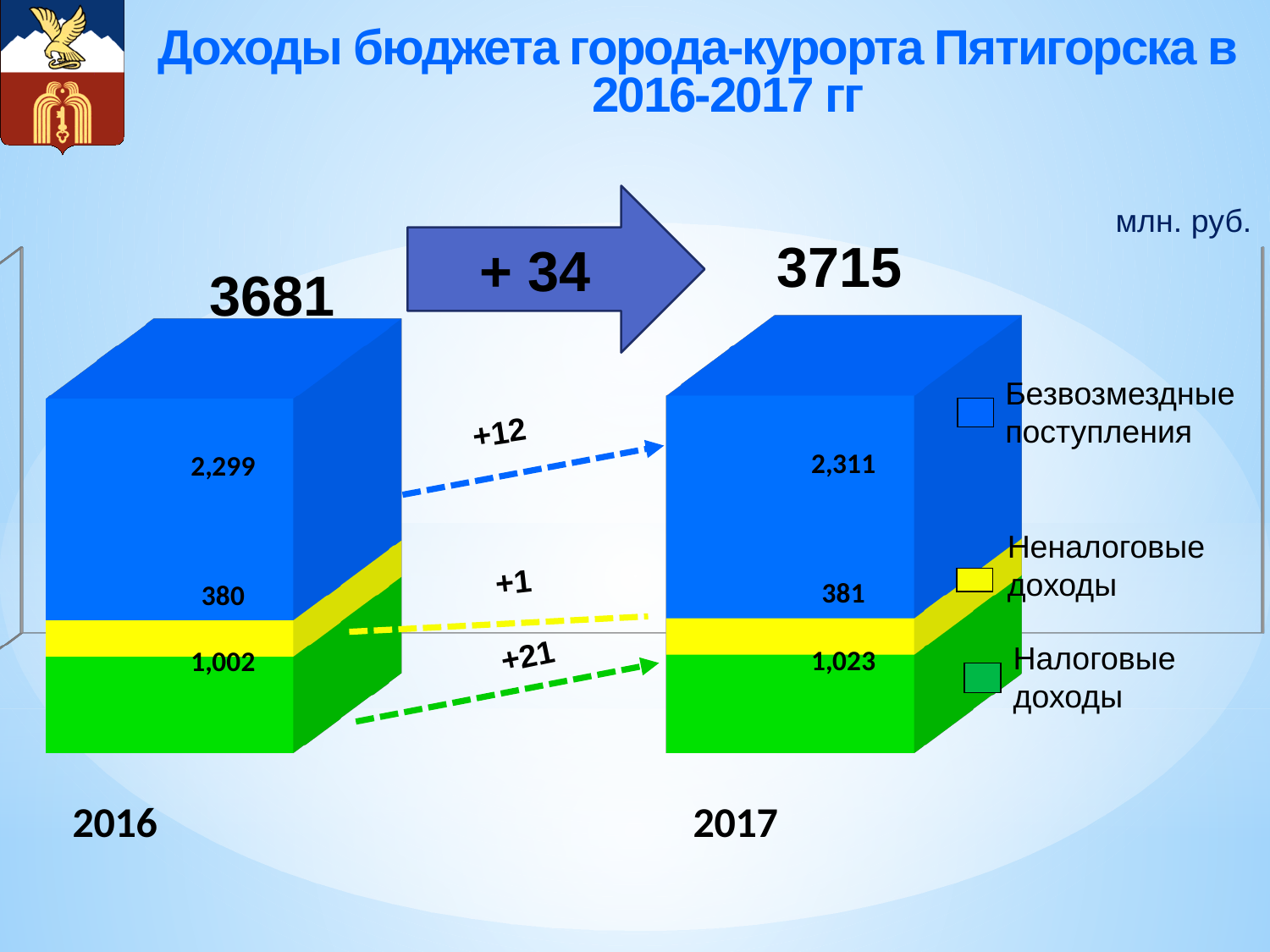
What is the difference between the 2017 and 2016 values for Налоговые доходы? 21 What is the value of Неналоговые доходы for 2016? 380 What is the value of Налоговые доходы for 2017? 1,023 Which series has the highest value in 2016? Безвозмездные поступления Which is larger: Неналоговые доходы in 2017 or in 2016? 2017 Which series has the lowest value in 2017? Неналоговые доходы What is the difference between the 2017 and 2016 values for Безвозмездные поступления? 12 What is the total of the stacked bar for 2016? 3681 What is the total of the stacked bar for 2017? 3715 How many series does the legend list? 3 What kind of chart is shown on the slide? Stacked bar chart What is the value of Безвозмездные поступления for 2016? 2,299